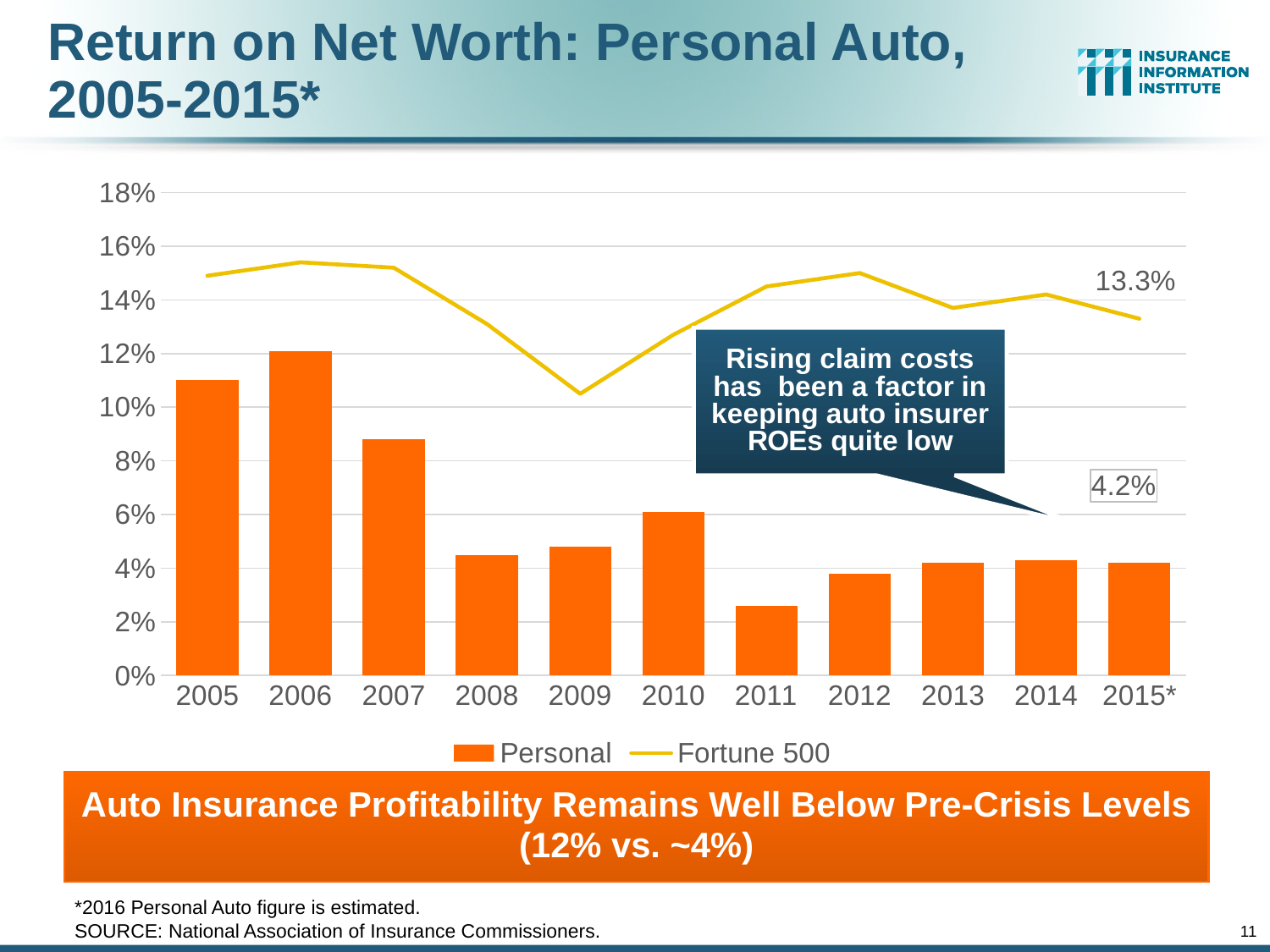
What is the Personal return on net worth for 2015*? 4.2% Which series is drawn as a line rather than bars? Fortune 500 In which year is the Personal bar the highest? 2006 In which year is the Personal bar the lowest? 2011 How many years are shown on the x axis? 11 Is the Fortune 500 value for 2009 greater or less than 12%? less Is the Personal value for 2011 greater or less than 4%? less What is the difference between the Fortune 500 and Personal values in 2015*? 9.1 percentage points Which year has a larger Personal value, 2005 or 2007? 2005 Is the Personal value for 2005 greater or less than 10%? greater What is the Fortune 500 value shown for 2015*? 13.3% How many series does the legend list? 2